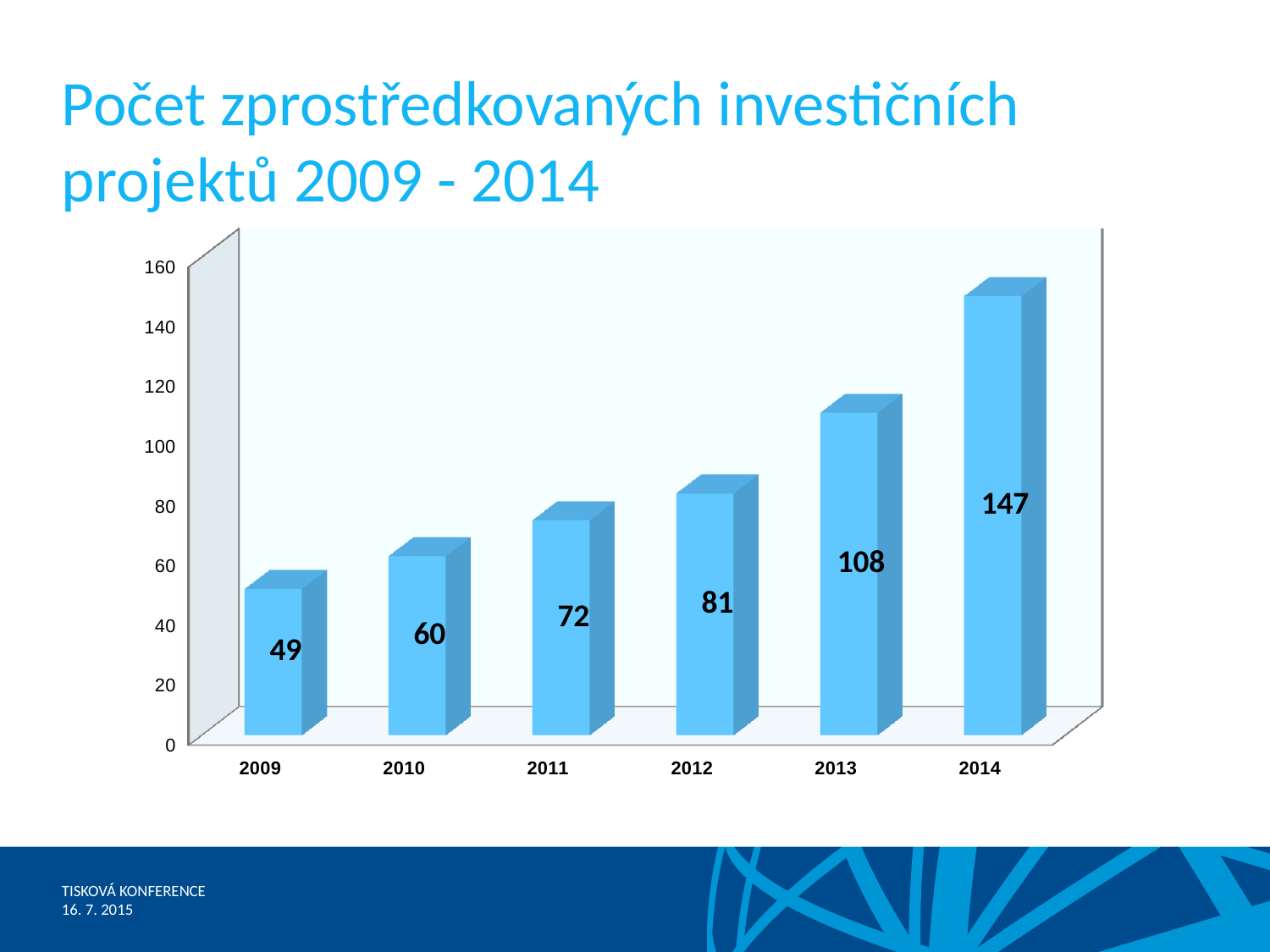
How many years are shown on the x axis? 6 What is the value for 2009? 49 Which year has the lowest value? 2009 What is the difference between the values for 2014 and 2013? 39 Do the values rise or fall from 2009 to 2014? rise What kind of chart is shown on the slide? bar chart What is the value for 2012? 81 What is the difference between the values for 2011 and 2010? 12 Which year has the highest value? 2014 What is the value for 2014? 147 Which is larger, the value for 2013 or the value for 2012? 2013 Is the value for 2013 greater or less than 100? greater